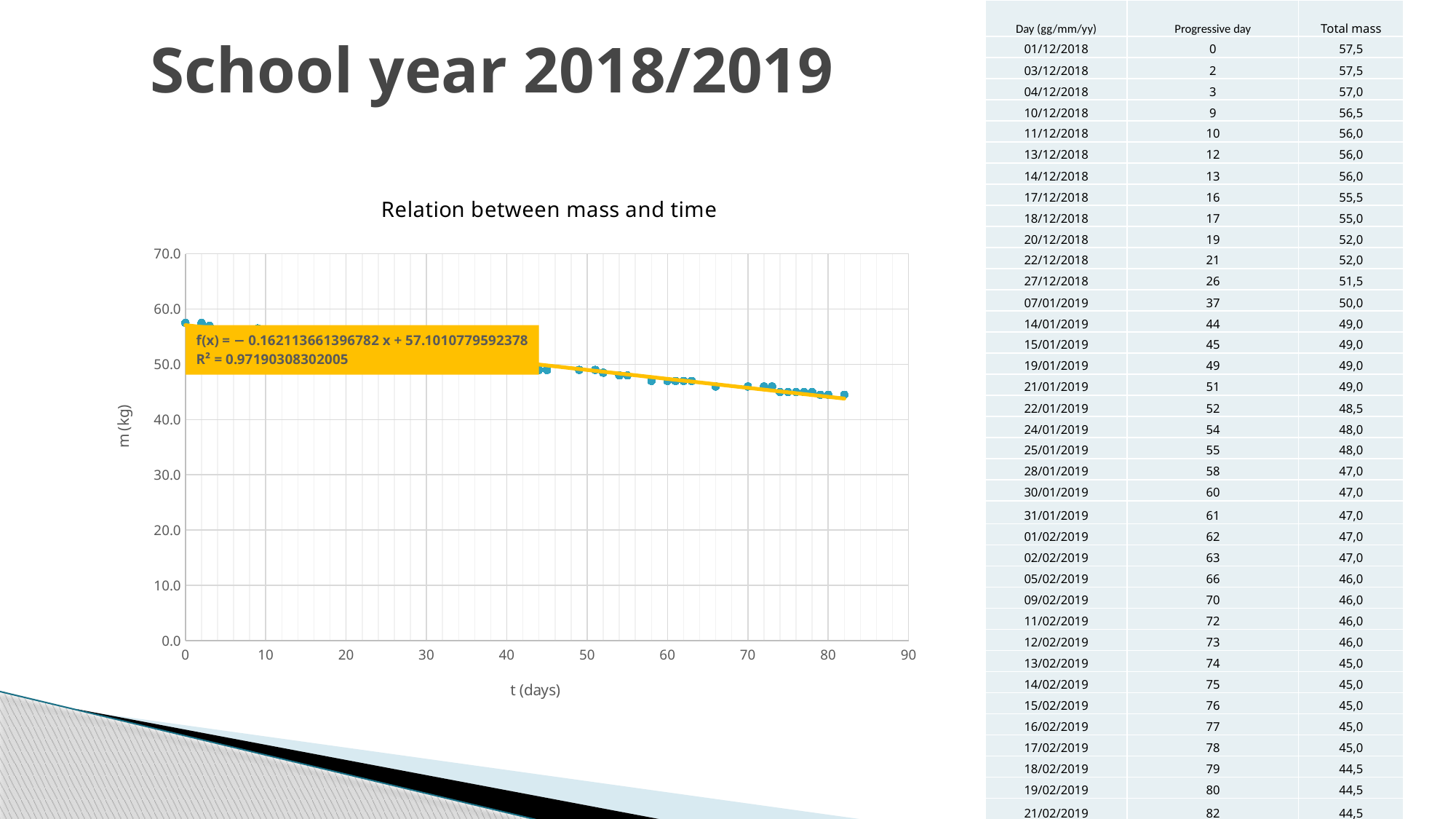
Is the mass value at t = 82 days greater or less than 40? greater Which has the larger mass value, the point at t = 0 days or the point at t = 82 days? t = 0 days Is the mass value at t = 60 days greater or less than 50? less Is the mass value at t = 0 days greater or less than 50? greater Do the plotted mass values rise or fall as t (days) increases? fall What kind of chart is shown on the slide? scatter chart What is the title of the chart? Relation between mass and time What R² value is shown on the chart for the trendline? 0.97190308302005